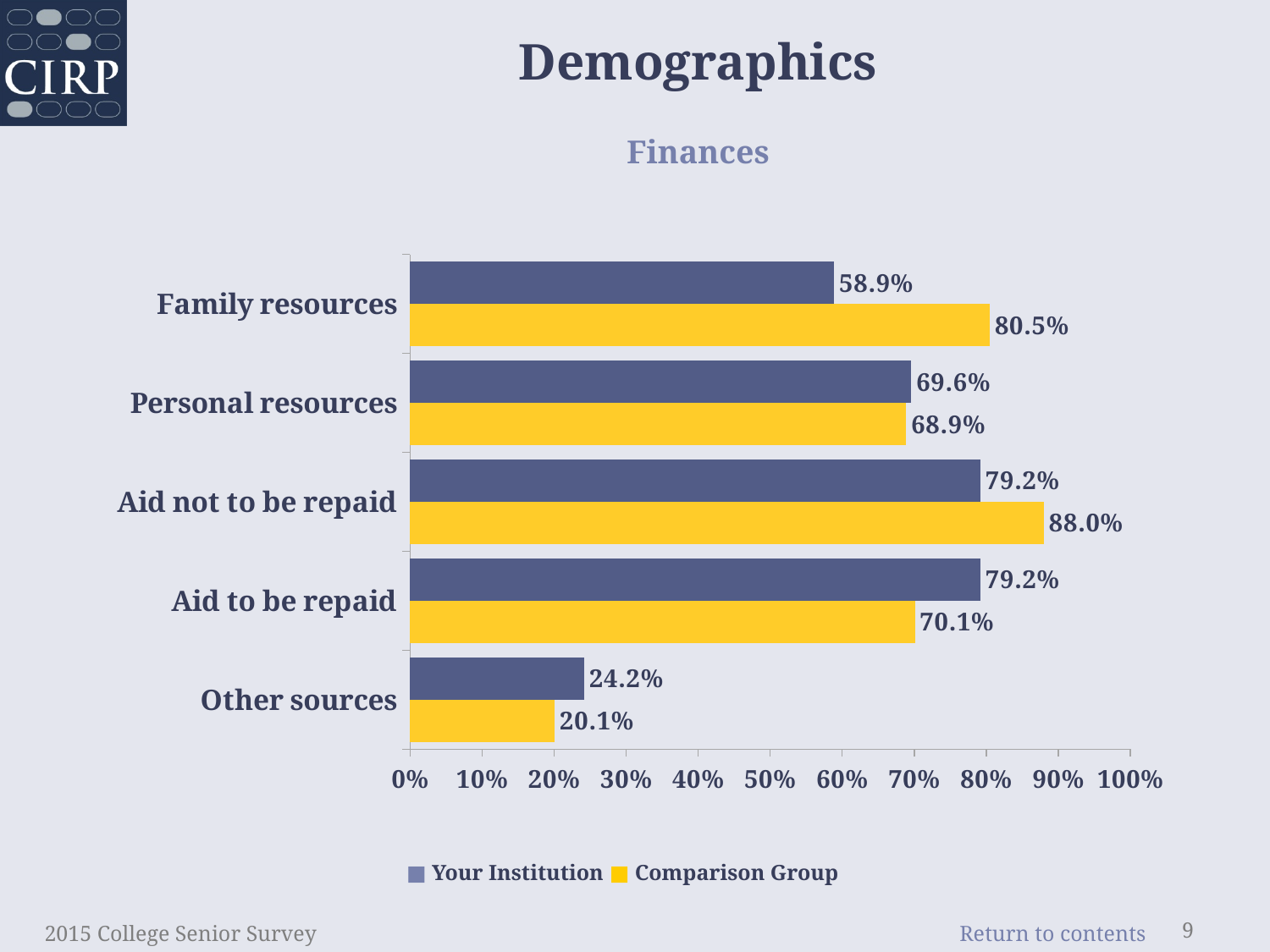
What is the Comparison Group value for Aid to be repaid? 70.1% What is the difference between the Comparison Group and Your Institution values for Family resources? 21.6 percentage points What is the Comparison Group value for Aid not to be repaid? 88.0% For Aid not to be repaid, which is larger: Your Institution or Comparison Group? Comparison Group What is the value for Your Institution for Family resources? 58.9% How many categories are shown on the chart? 5 What kind of chart is shown on the slide? Bar chart What is the value for Your Institution for Other sources? 24.2% Which category has the lowest value for Your Institution? Other sources Which category has the highest Comparison Group value? Aid not to be repaid How many series does the legend list? 2 Is the Comparison Group value for Other sources greater or less than 30%? less